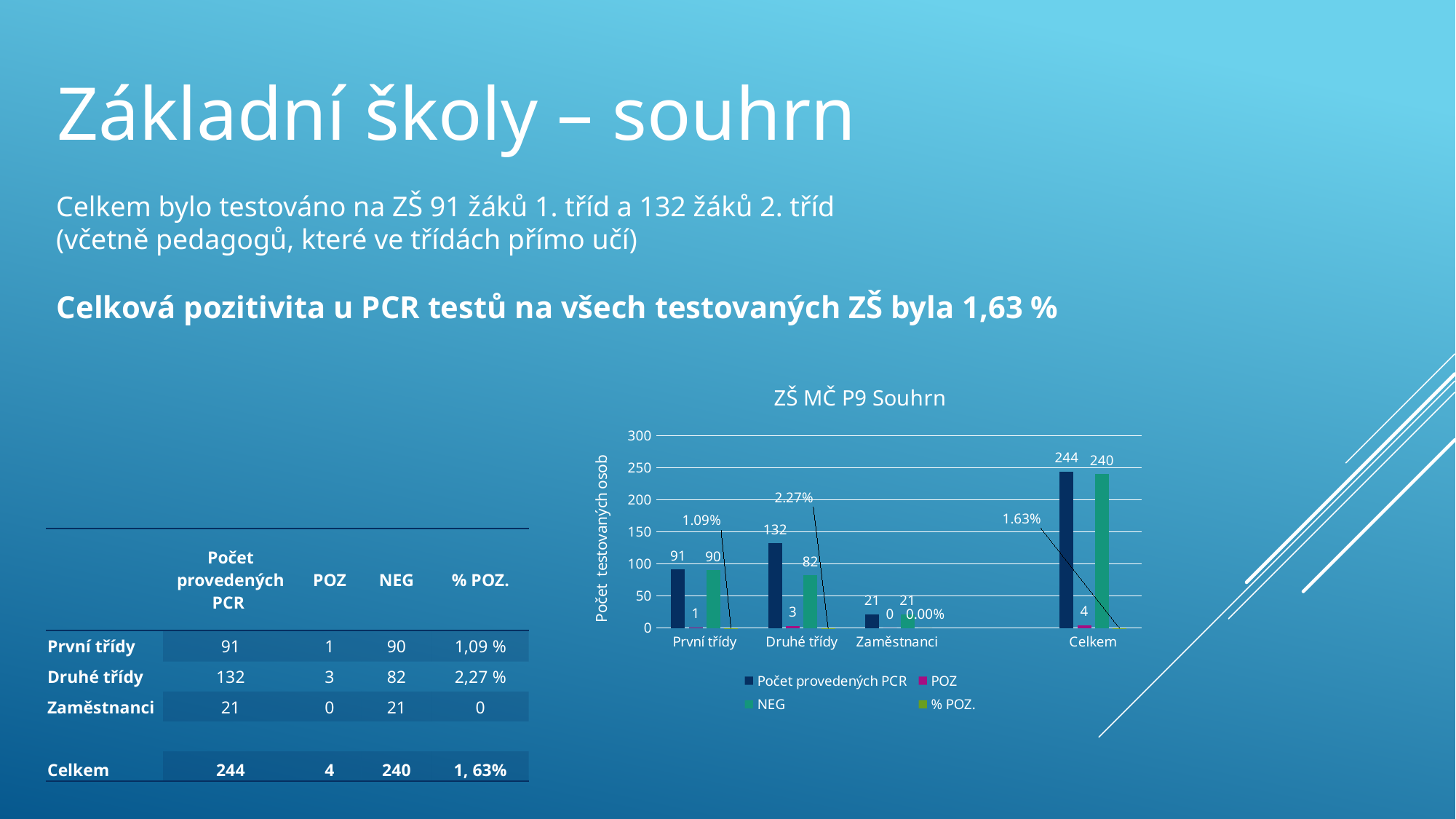
What is the difference between the Počet provedených PCR values for Druhé třídy and První třídy? 41 Which category has the highest Počet provedených PCR value in the chart? Celkem What % POZ. value is shown for První třídy in the chart? 1.09% How many series does the chart legend list? 4 What is the POZ value for Druhé třídy in the chart? 3 How many categories are shown on the x axis of the chart? 4 Is the Počet provedených PCR value for Celkem greater or less than 200? greater What is the NEG value for Celkem in the chart? 240 Which category has the lowest NEG value in the chart? Zaměstnanci Which is larger, the NEG value for První třídy or the NEG value for Druhé třídy? První třídy What is the value of Počet provedených PCR for Druhé třídy in the chart? 132 What type of chart is shown on the slide? bar chart